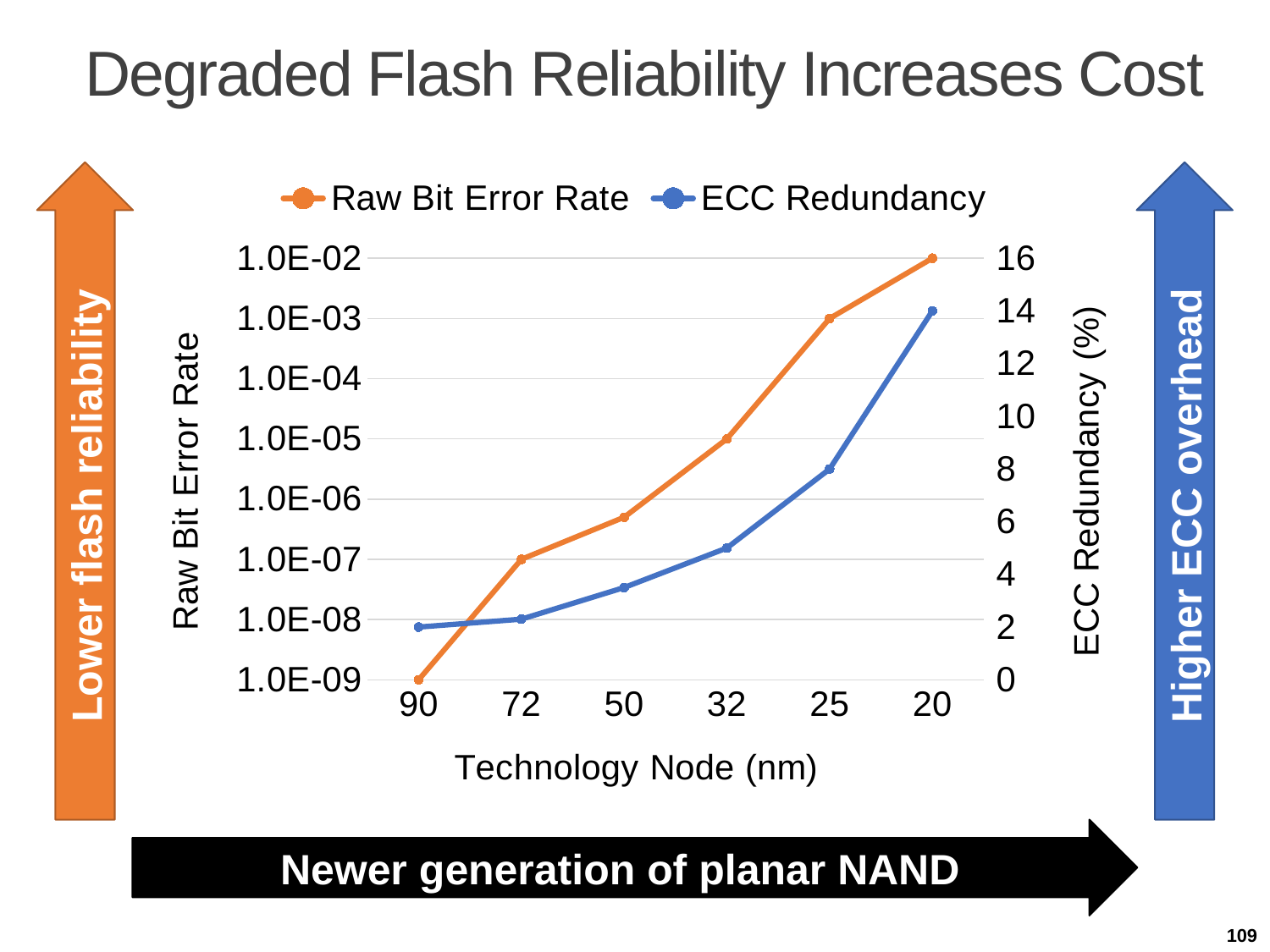
What is the Raw Bit Error Rate at the 20 nm technology node? 1.0E-02 What kind of chart is shown on the slide? line chart Which technology node has the lowest Raw Bit Error Rate? 90 How many technology nodes are plotted on the x axis? 6 What is the title of the x axis? Technology Node (nm) How many series does the legend list? 2 What is the Raw Bit Error Rate at the 25 nm technology node? 1.0E-03 Is the ECC Redundancy at the 50 nm technology node greater or less than 4? less What is the Raw Bit Error Rate at the 90 nm technology node? 1.0E-09 Which technology node has the highest ECC Redundancy? 20 What is the ECC Redundancy (%) at the 20 nm technology node? 14 What is the ECC Redundancy (%) at the 25 nm technology node? 8